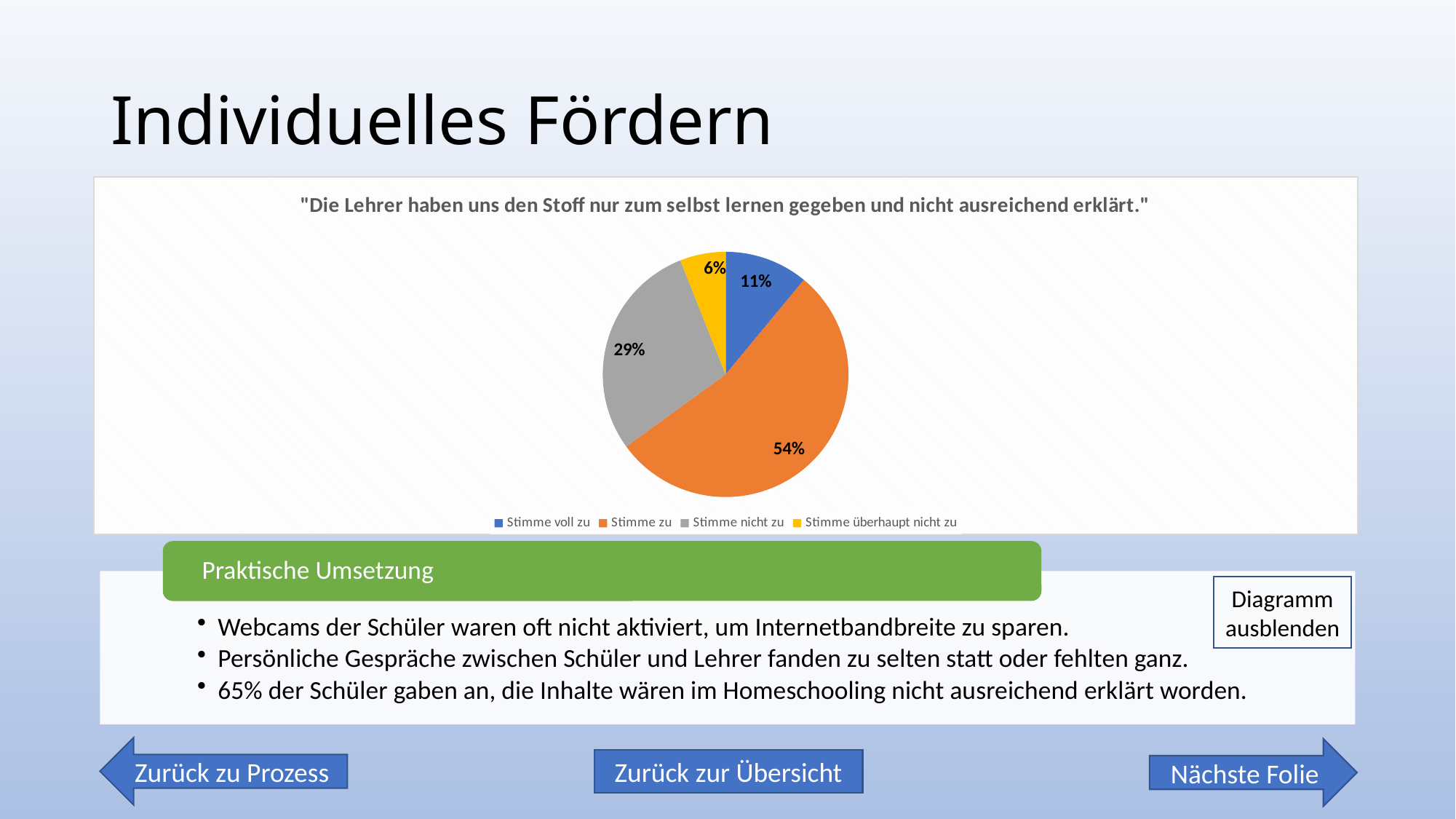
What share of the pie does "Stimme nicht zu" represent? 29% What share of the pie does "Stimme zu" represent? 54% Which category has the smallest slice of the pie? Stimme überhaupt nicht zu What share of the pie does "Stimme voll zu" represent? 11% What is the difference in percentage points between "Stimme zu" and "Stimme nicht zu"? 25 What is the combined share of "Stimme voll zu" and "Stimme zu"? 65% Which is larger, the slice for "Stimme voll zu" or the slice for "Stimme überhaupt nicht zu"? Stimme voll zu What kind of chart is shown on the slide? Pie chart How many categories does the pie chart show? 4 Which category has the largest slice of the pie? Stimme zu Which colour represents "Stimme nicht zu" in the pie chart? Grey